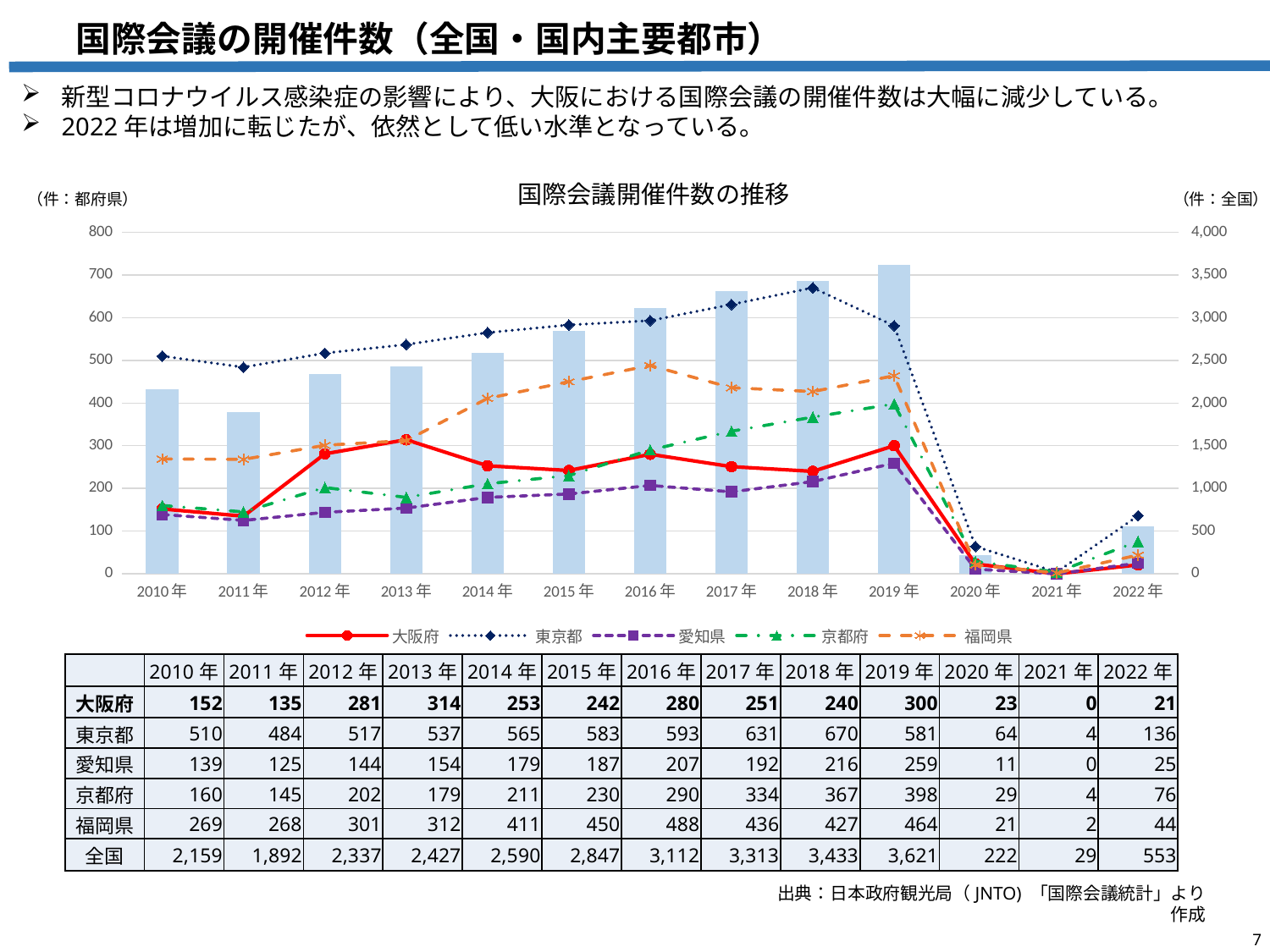
Is the 全国 bar for 2019年 greater or less than 3,500 on the right axis? greater In which year does 東京都 reach its highest value? 2018年 Which is larger in 2017年, 京都府 or 福岡県? 福岡県 What is the value for 全国 in 2016年? 3,112 How many series does the legend list? 5 In which year does 大阪府 have its lowest value? 2021年 What is the value for 大阪府 in 2019年? 300 What is the difference between 東京都 and 大阪府 in 2018年? 430 How many years are shown on the x axis? 13 Does the 東京都 line rise or fall from 2010年 to 2018年? rises What is the value for 愛知県 in 2022年? 25 What kind of chart is this? Combined bar and line chart